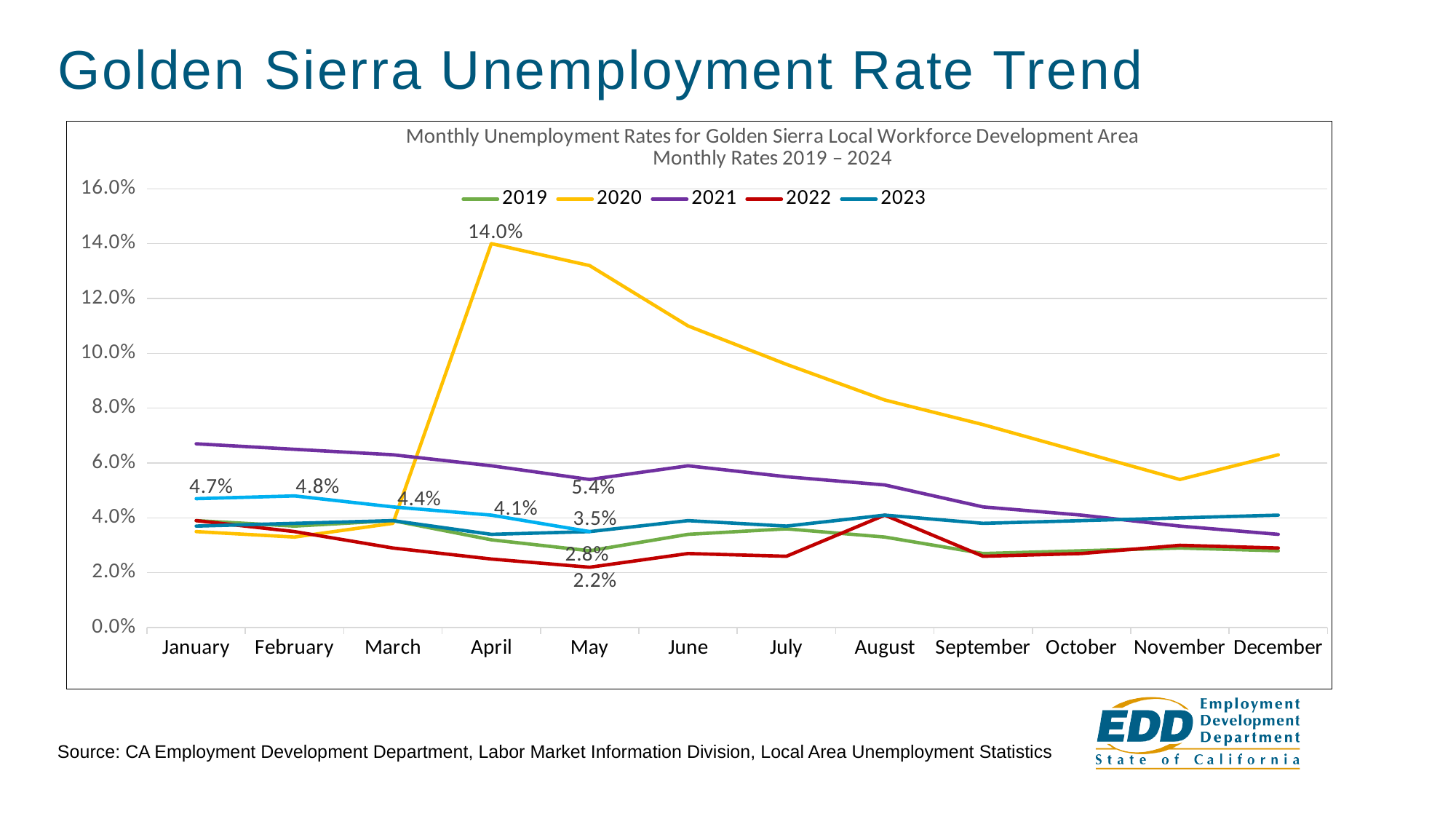
How many months are shown along the x axis? 12 In January, which series has the larger value, 2021 or 2019? 2021 What is the unemployment rate for 2019 in May? 2.8% What is the unemployment rate for 2020 in April? 14.0% Is the value for 2020 in June greater or less than 10.0%? greater What is the difference between the 2021 and 2022 unemployment rates in May? 3.2% How many series does the chart legend list? 5 What is the unemployment rate for 2022 in May? 2.2% What is the unemployment rate for 2021 in May? 5.4% In which month does the 2020 series reach its highest value? April What kind of chart is shown on the slide? Line chart Does the 2020 series rise or fall from April to November? Fall